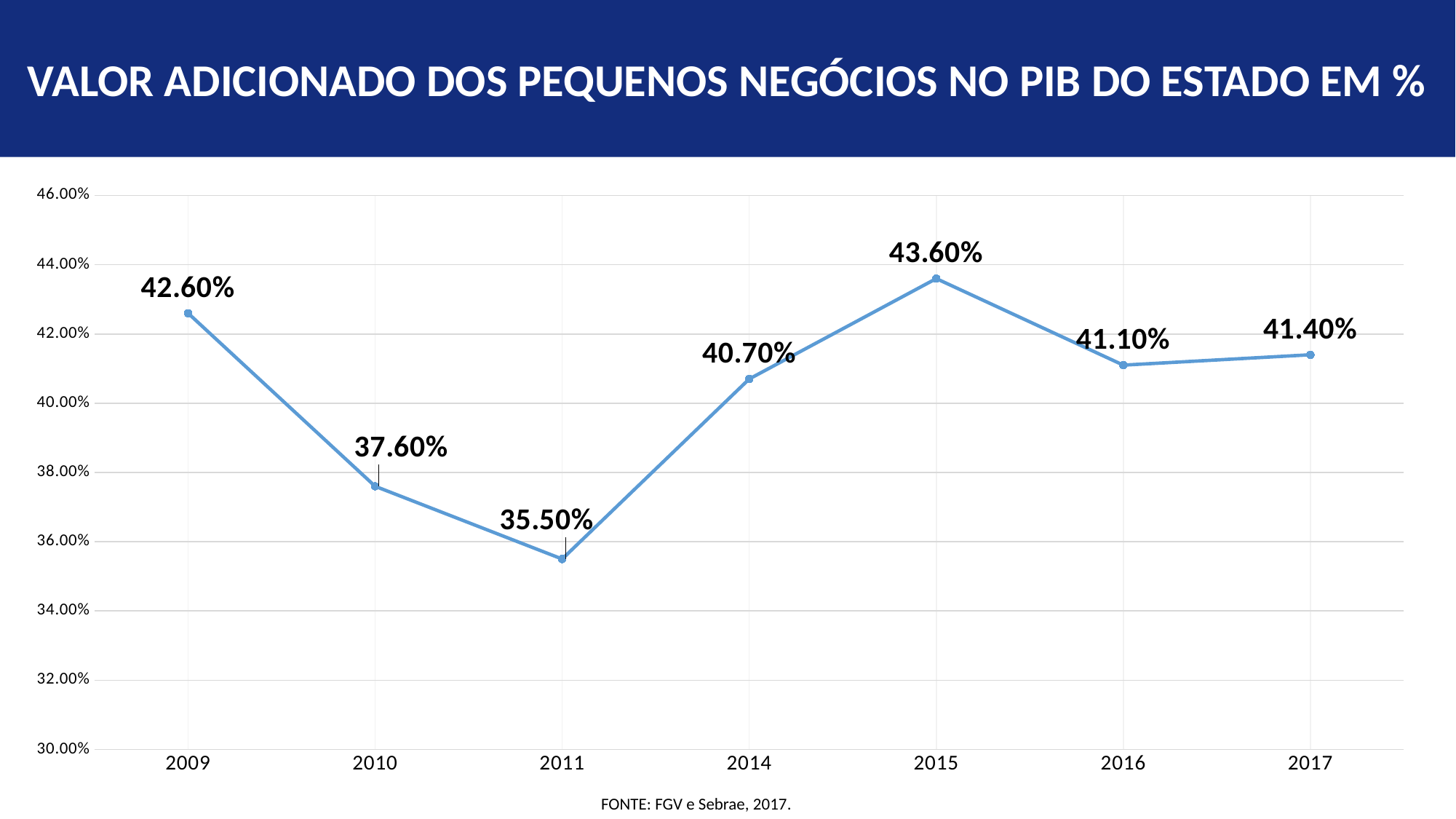
What is the value for 2015? 43.60% Which is larger, the value for 2014 or the value for 2016? 2016 What is the value for 2011? 35.50% How many years are plotted on the chart? 7 What is the difference between the values for 2015 and 2011? 8.10% What kind of chart is shown on the slide? line chart Which year has the lowest value? 2011 What is the value for 2009? 42.60% What is the difference between the values for 2009 and 2010? 5.00% What is the value for 2017? 41.40% Which year has the highest value? 2015 Do the values rise or fall from 2009 to 2011? fall